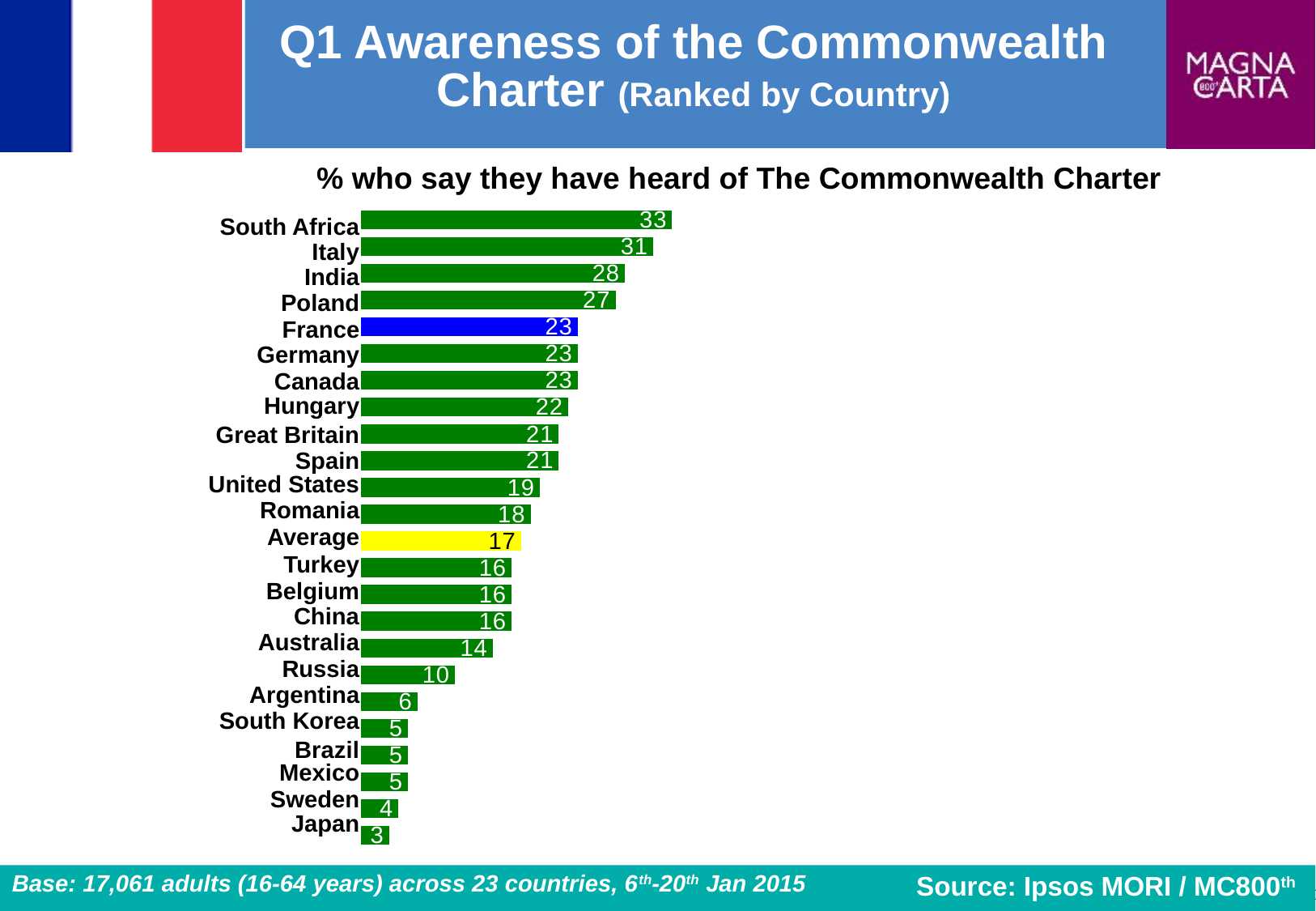
Which bar is coloured yellow? Average What is the value for France? 23 Which country has the highest value? South Africa Which is larger, the value for Hungary or the value for Australia? Hungary What is the value shown for Average? 17 What is the difference between the values for Poland and Russia? 17 Which country has the lowest value? Japan What kind of chart is shown on the slide? Bar chart What is the difference between the values for Italy and India? 3 What is the value for Japan? 3 What is the value for South Africa? 33 How many bars are plotted in the chart, including the Average bar? 24